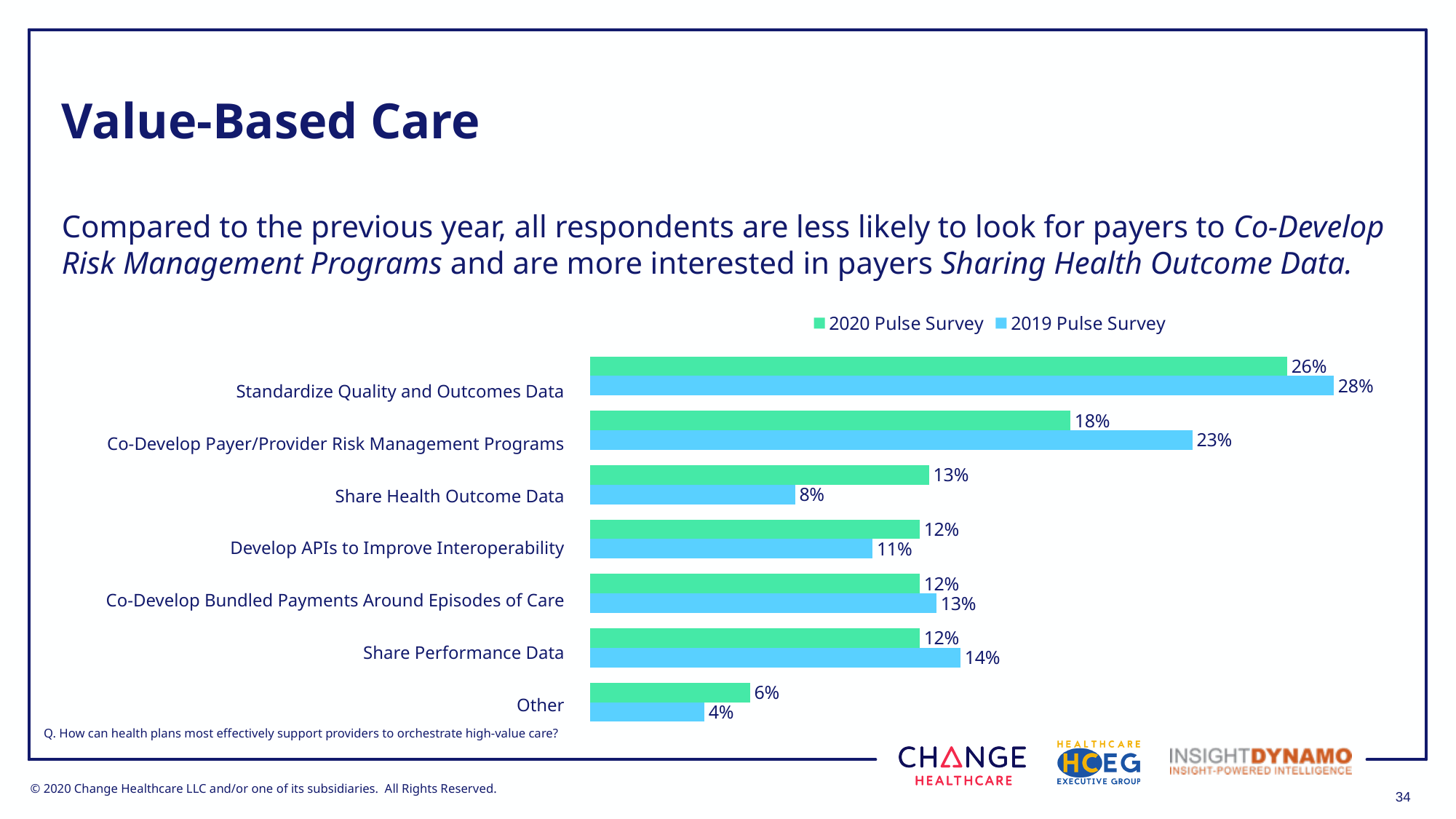
Which series is shown in green in the legend? 2020 Pulse Survey Which is larger for Share Health Outcome Data: the 2020 Pulse Survey value or the 2019 Pulse Survey value? 2020 Pulse Survey What is the difference between the 2019 and 2020 Pulse Survey values for Co-Develop Payer/Provider Risk Management Programs? 5% Which category has the highest 2019 Pulse Survey value? Standardize Quality and Outcomes Data What is the 2019 Pulse Survey value for Share Health Outcome Data? 8% What is the 2019 Pulse Survey value for Co-Develop Payer/Provider Risk Management Programs? 23% How many categories are shown in the chart? 7 Which category has the lowest 2020 Pulse Survey value? Other What kind of chart is shown on the slide? Bar chart What is the 2020 Pulse Survey value for Other? 6% How many series does the legend list? 2 What is the 2020 Pulse Survey value for Standardize Quality and Outcomes Data? 26%